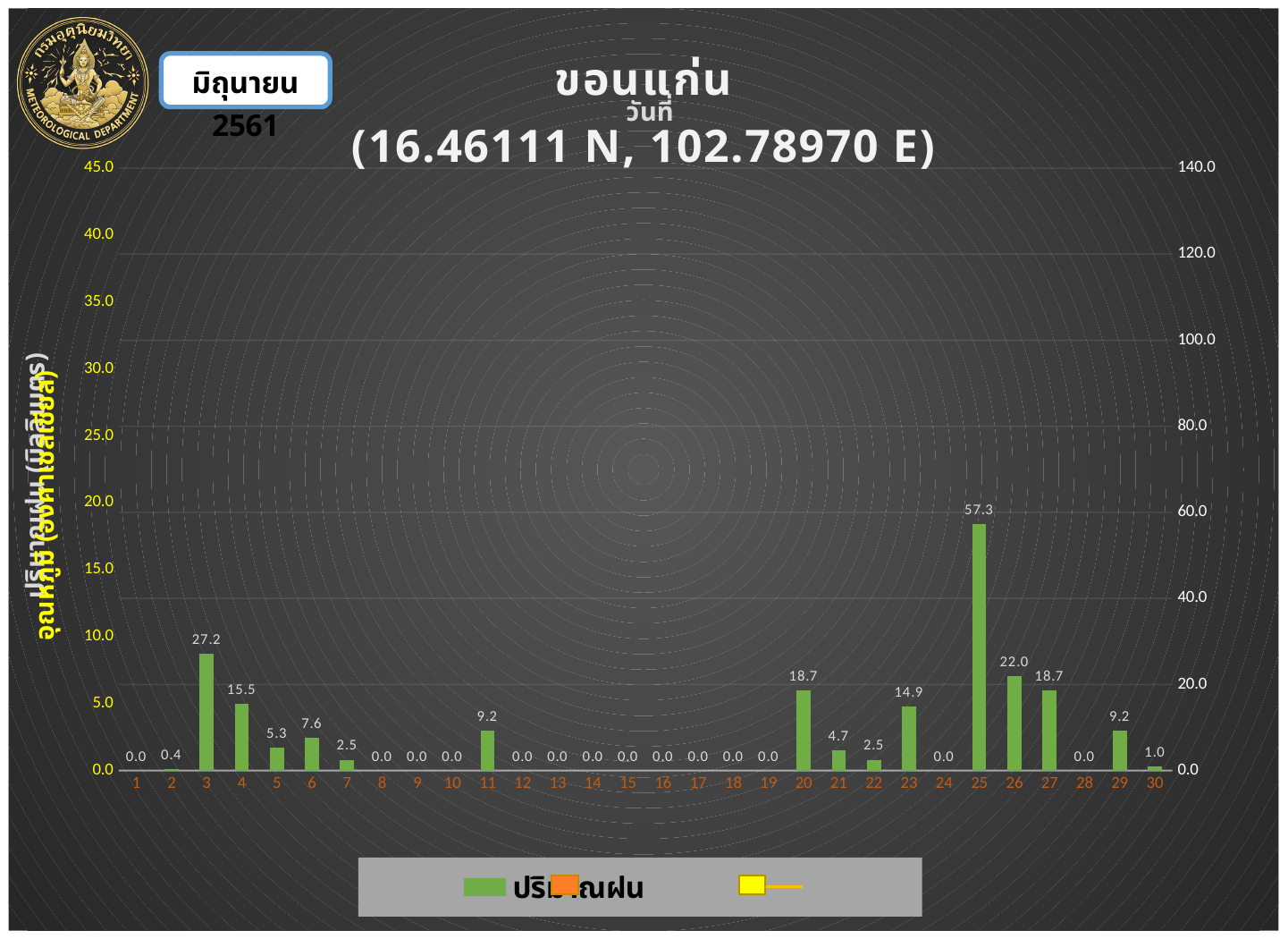
What coordinates are given in the chart title? (16.46111 N, 102.78970 E) What kind of chart is shown on the slide? bar chart What is the value for day 30 in the ขอนแก่น chart? 1.0 What is the value for day 20 in the ขอนแก่น chart? 18.7 How many days are shown on the x axis of the ขอนแก่น chart? 30 What is the value for day 3 in the ขอนแก่น chart? 27.2 What is the difference between the values for day 26 and day 27 in the ขอนแก่น chart? 3.3 What is the value for day 25 in the ขอนแก่น chart? 57.3 Which day has the highest value in the ขอนแก่น chart? 25 Which is larger in the ขอนแก่น chart, the value for day 4 or the value for day 23? day 4 Is the value for day 25 in the ขอนแก่น chart greater or less than 40.0 on the right-hand axis? greater What is the difference between the values for day 3 and day 4 in the ขอนแก่น chart? 11.7